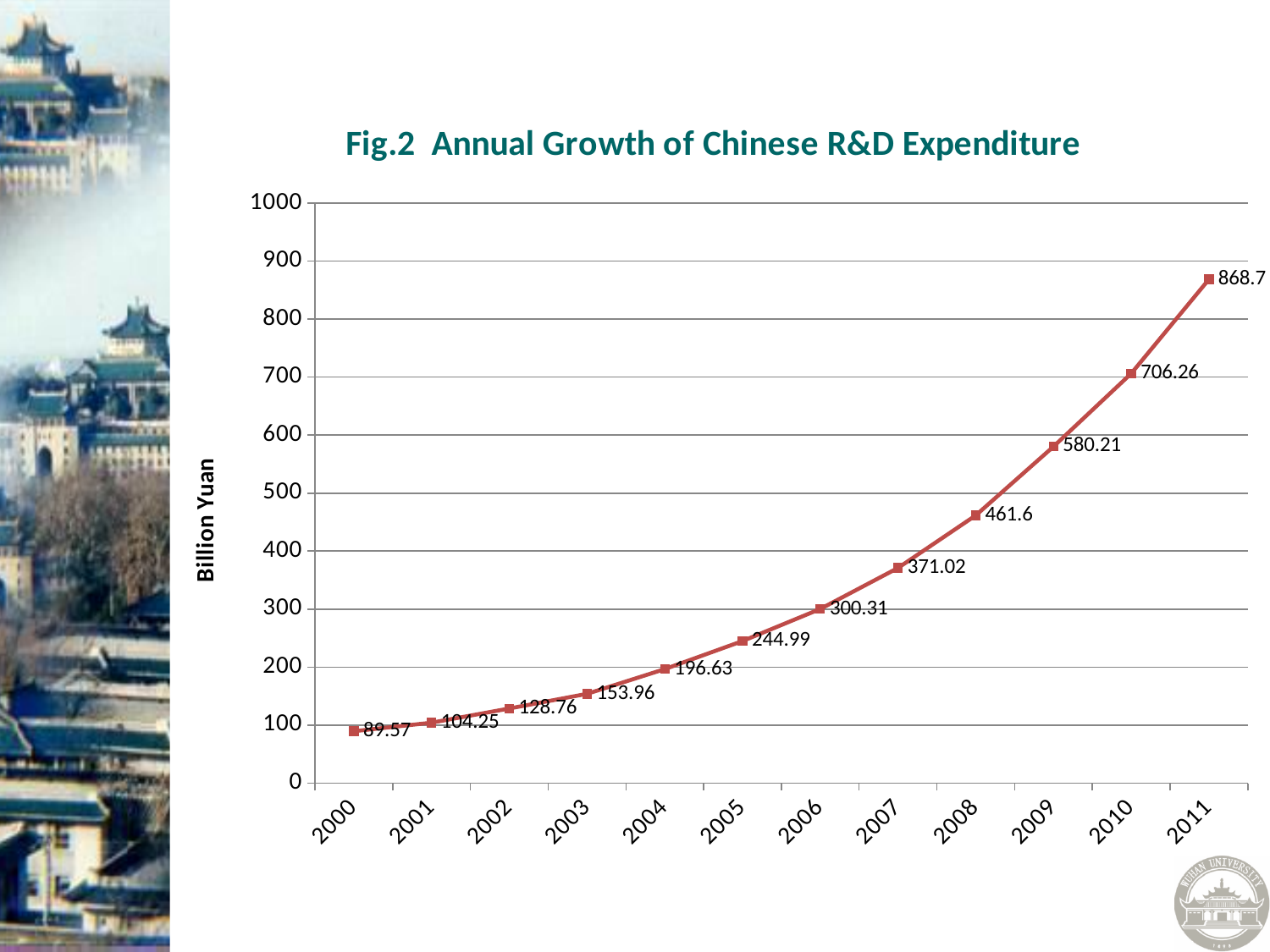
Which year has a larger value, 2008 or 2007? 2008 What is the R&D expenditure value for 2005? 244.99 What kind of chart is shown? line chart Which year has the lowest R&D expenditure? 2000 Which year has the highest R&D expenditure? 2011 What is the R&D expenditure value for 2000? 89.57 What is the difference between the values for 2011 and 2010? 162.44 Do the values rise or fall from 2000 to 2011? rise Is the value for 2009 greater or less than 500? greater How many years are plotted on the x axis? 12 What is the R&D expenditure value for 2011? 868.7 What is the label on the vertical axis? Billion Yuan